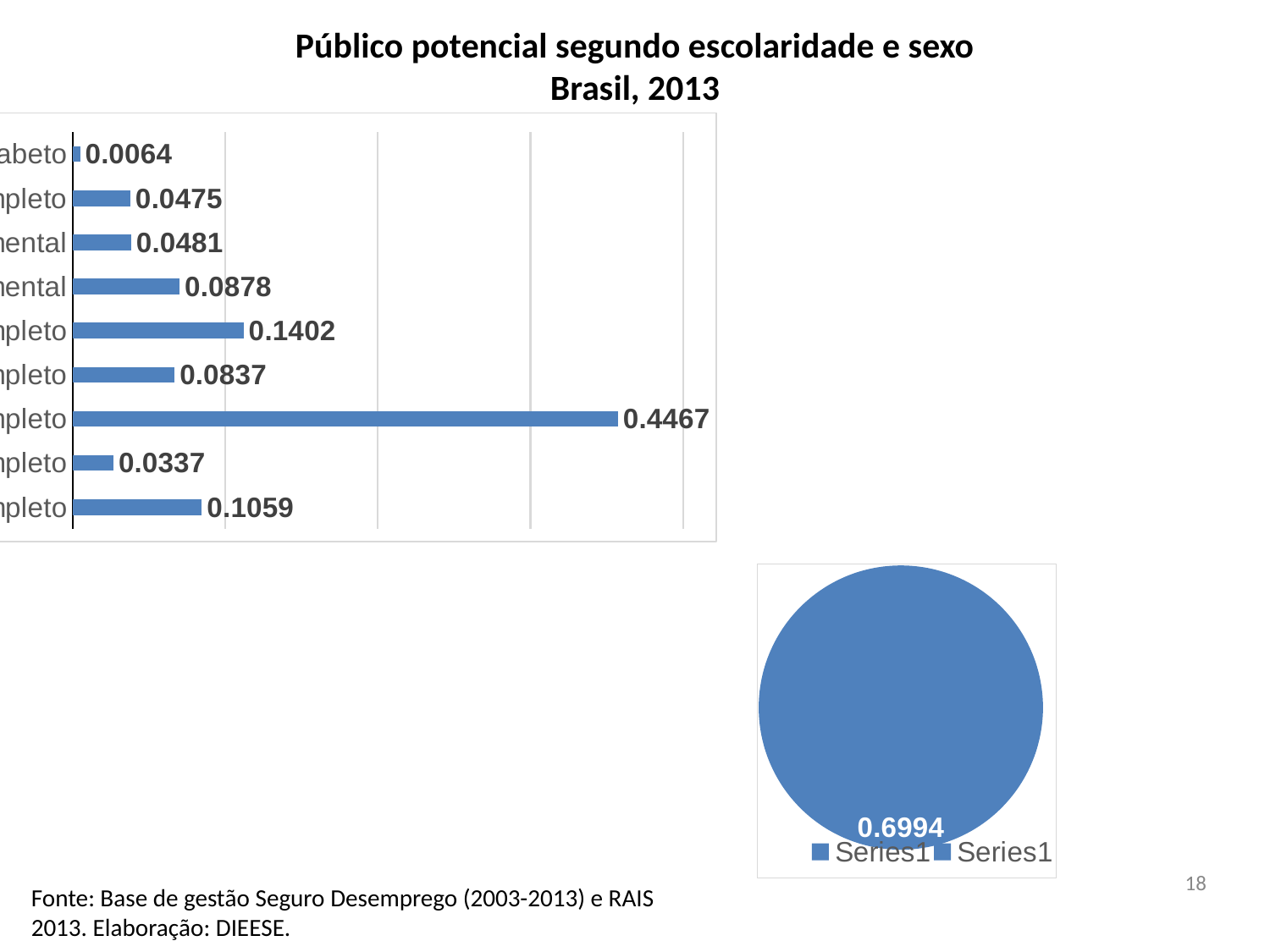
In the bar chart, which is larger: the value of the second bar from the top (0.0475) or the third bar from the top (0.0481)? 0.0481 In the bar chart, what is the value of the topmost bar? 0.0064 In the bar chart, what is the difference between the largest value (0.4467) and the smallest value (0.0064)? 0.4403 In the bar chart, what is the largest value shown? 0.4467 What is the title of the slide's chart? Público potencial segundo escolaridade e sexo Brasil, 2013 In the bar chart, what is the value of the bottom bar? 0.1059 In the bar chart, what is the value of the fifth bar from the top? 0.1402 In the bar chart, what is the smallest value shown? 0.0064 In the bar chart, how many bars are plotted? 9 What kind of chart is the chart at the top left of the slide? bar chart What kind of chart is the chart at the bottom right of the slide? pie chart In the pie chart, what value is printed on the visible slice? 0.6994